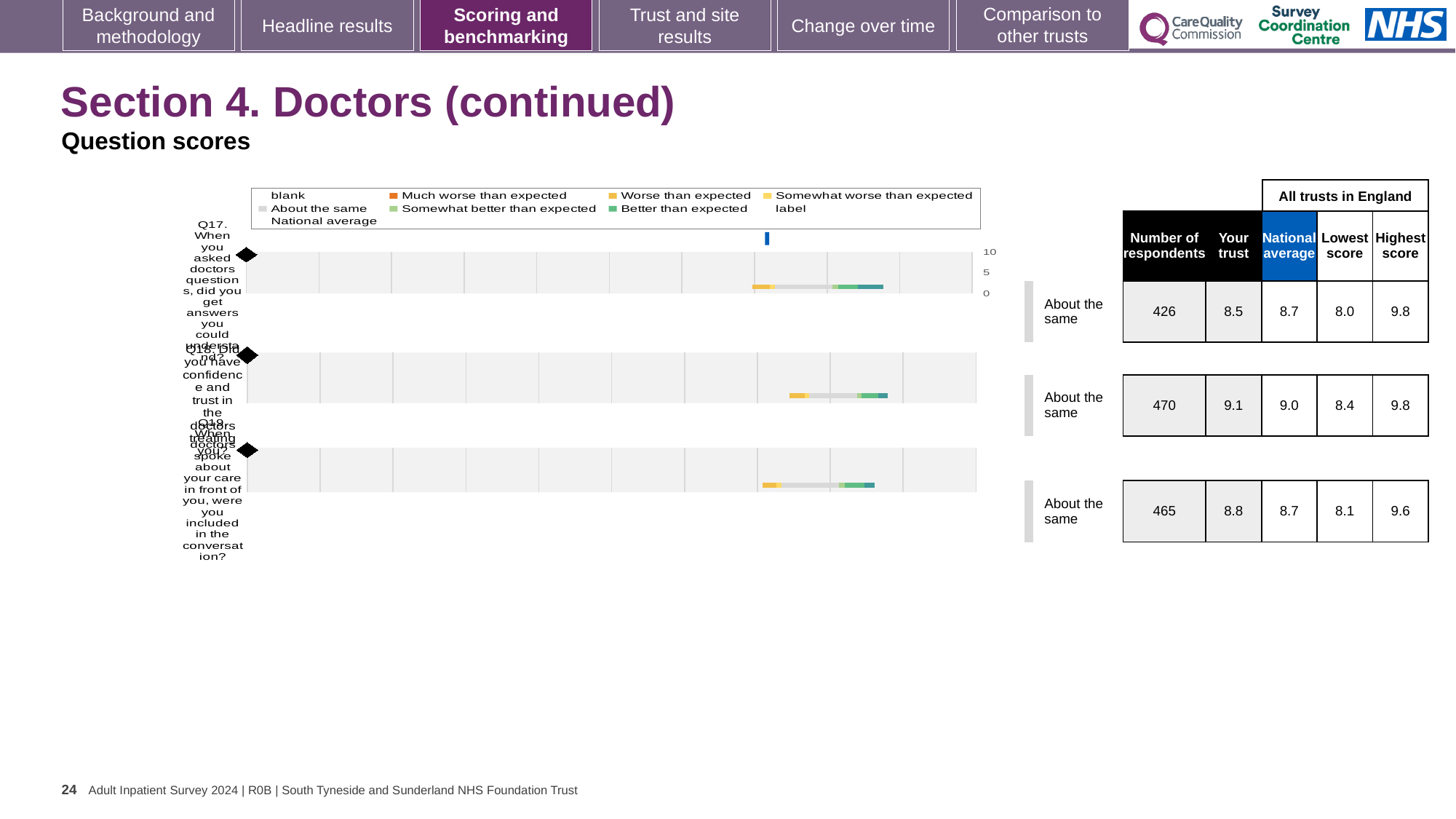
What is the highest score across all trusts in England for Q18? 9.8 What kind of chart is shown on the slide? bar chart According to the table beside the chart, what is the national average score for Q17? 8.7 Which question has the lowest 'Your trust' score? Q17 According to the table beside the chart, what is the 'Your trust' score for Q18? 9.1 How many questions (bars) are plotted in the chart? 3 What is the difference between the 'Your trust' score and the national average for Q18? 0.1 How many respondents are listed for Q19? 465 What benchmark category is shown for Q17? About the same For Q19, which is larger: the 'Your trust' score or the national average? Your trust Which question has the highest 'Your trust' score? Q18